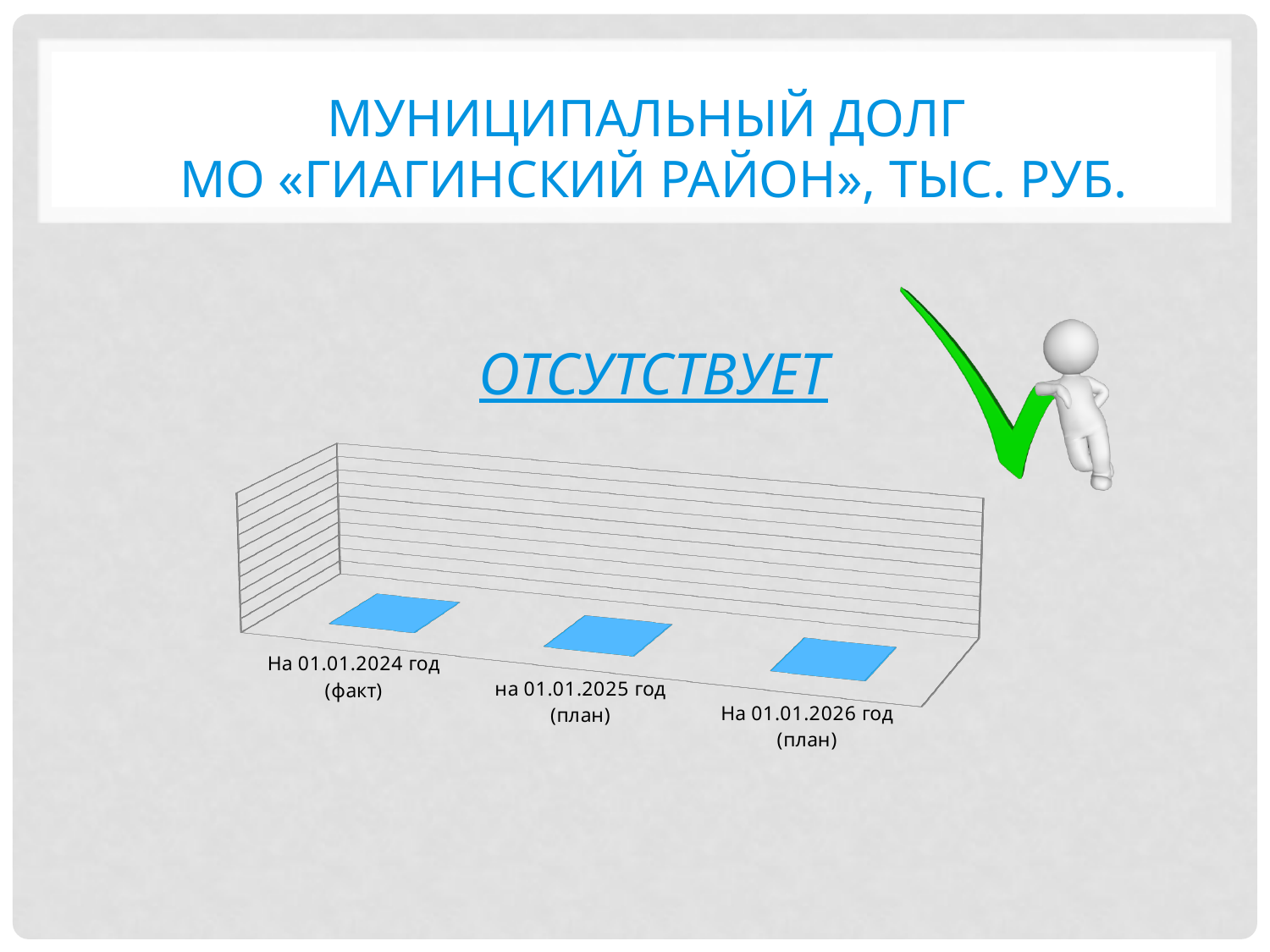
How many categories are shown on the x axis of the chart? 3 What is the label of the last category on the chart's x axis? На 01.01.2026 год (план) Do the bar heights rise, fall, or stay the same across the three categories? stay the same What is the label of the first category on the chart's x axis? На 01.01.2024 год (факт) What kind of chart is shown on the slide? bar chart